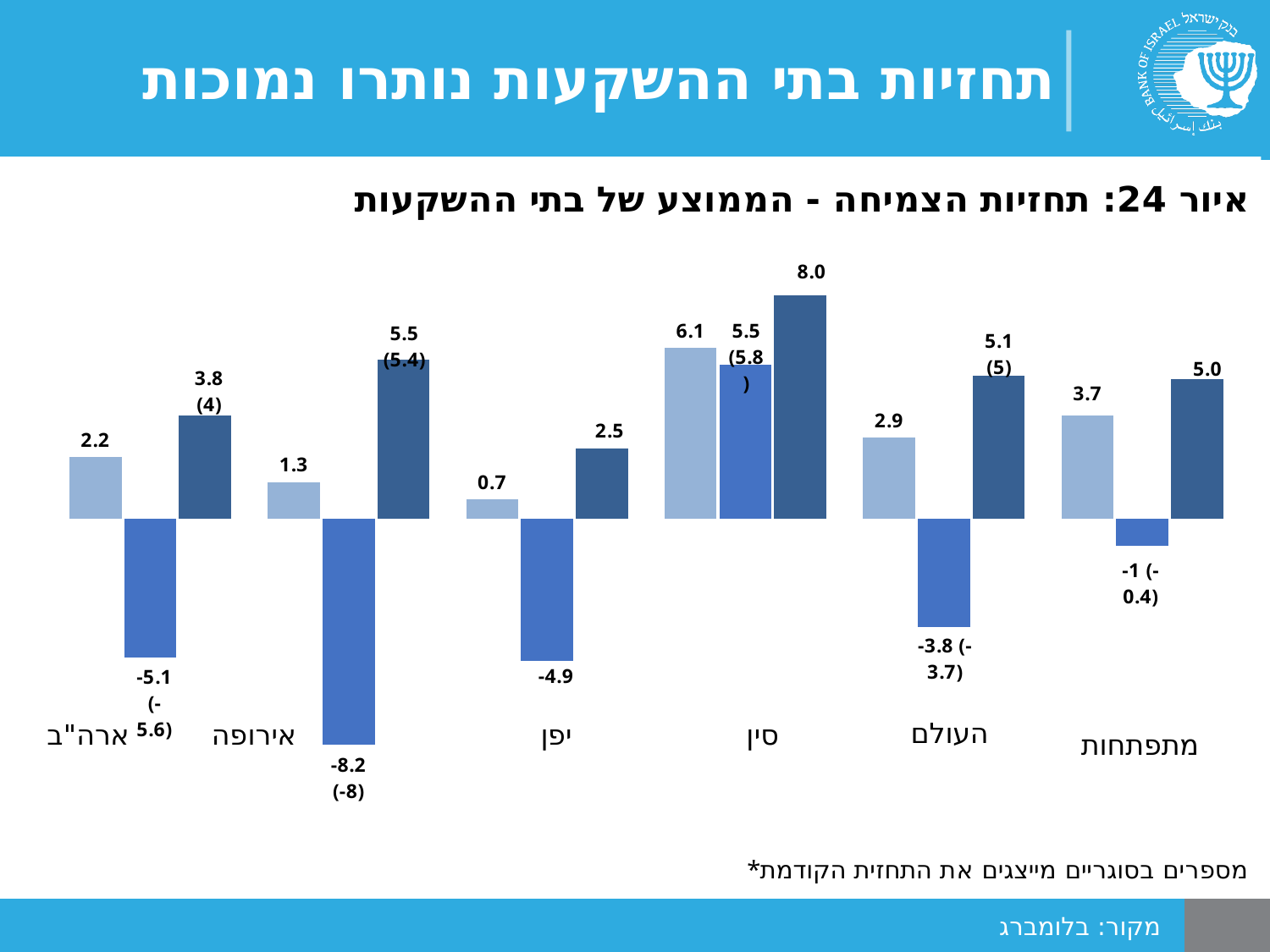
What is the value of the medium blue (middle) bar for אירופה? -8.2 What is the value of the dark blue (rightmost) bar for סין? 8.0 What is the title of the chart? איור 24: תחזיות הצמיחה - הממוצע של בתי ההשקעות Which is larger: the light blue bar for העולם or the light blue bar for מתפתחות? מתפתחות What value in parentheses is shown for the middle bar of העולם, representing the previous forecast? (-3.7) What is the value of the light blue (leftmost) bar for ארה"ב? 2.2 Which category has the highest value among the dark blue (rightmost) bars? סין What is the value of the middle bar for יפן? -4.9 What type of chart is shown on the slide? bar chart How many categories are shown along the x axis of the chart? 6 Which category has the lowest value among the medium blue (middle) bars? אירופה What is the difference between the dark blue bar for סין (8.0) and the dark blue bar for יפן (2.5)? 5.5